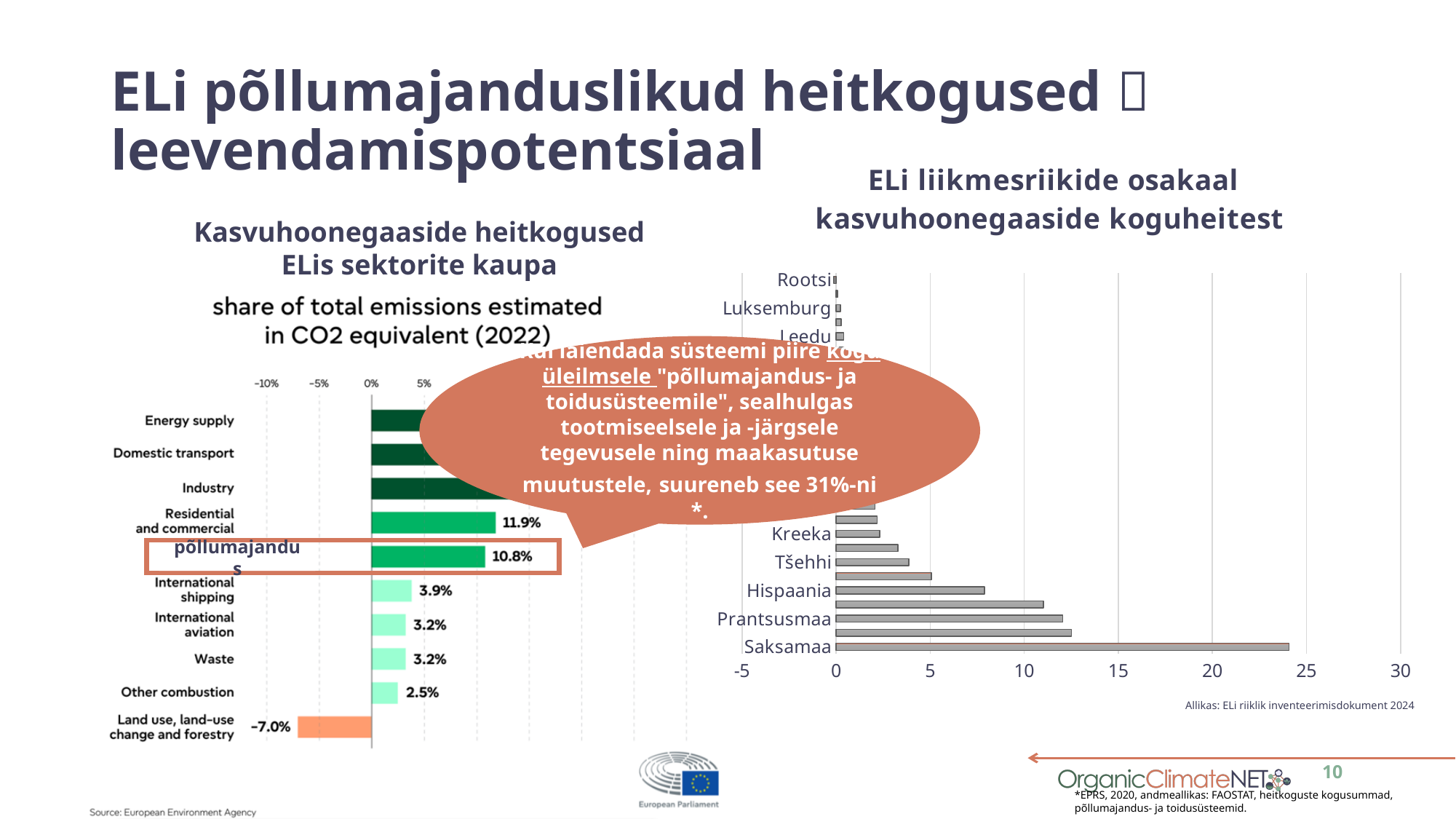
In the right chart (ELi liikmesriikide osakaal kasvuhoonegaaside koguheitest), is the value for Hispaania greater or less than 10? less In the right chart (ELi liikmesriikide osakaal kasvuhoonegaaside koguheitest), which country has the highest share? Saksamaa In the left chart (Kasvuhoonegaaside heitkogused ELis sektorite kaupa), what is the share for Residential and commercial? 11.9% In the left chart (Kasvuhoonegaaside heitkogused ELis sektorite kaupa), what is the share for International shipping? 3.9% In the right chart (ELi liikmesriikide osakaal kasvuhoonegaaside koguheitest), is the value for Saksamaa greater or less than 20? greater In the left chart (Kasvuhoonegaaside heitkogused ELis sektorite kaupa), which is larger: International shipping or Waste? International shipping In the left chart (Kasvuhoonegaaside heitkogused ELis sektorite kaupa), which category has the lowest (negative) value? Land use, land-use change and forestry In the left chart (Kasvuhoonegaaside heitkogused ELis sektorite kaupa), what is the value for Land use, land-use change and forestry? -7.0% What kind of chart is the right chart (ELi liikmesriikide osakaal kasvuhoonegaaside koguheitest)? bar chart In the left chart (Kasvuhoonegaaside heitkogused ELis sektorite kaupa), what is the difference between the Residential and commercial share and the põllumajandus share? 1.1% In the left chart (Kasvuhoonegaaside heitkogused ELis sektorite kaupa), what is the share for the highlighted põllumajandus (agriculture) bar? 10.8% In the left chart (Kasvuhoonegaaside heitkogused ELis sektorite kaupa), what is the share for Other combustion? 2.5%